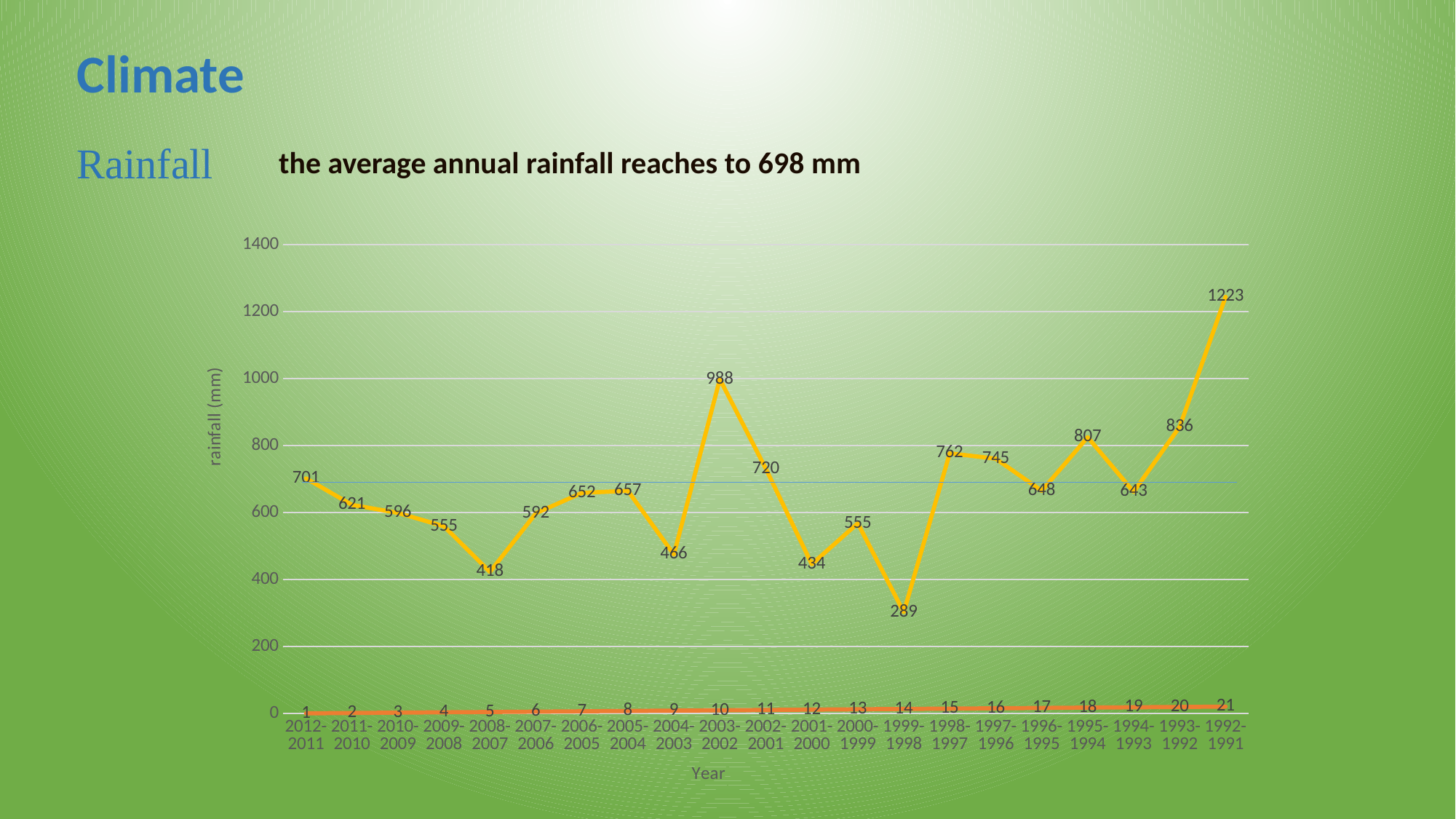
What is the rainfall value for 2003-2002? 988 Which year has the highest rainfall? 1992-1991 Which year has the lowest rainfall? 1999-1998 What is the difference in rainfall between 2003-2002 and 2004-2003? 522 What is the label of the y axis? rainfall (mm) Which has higher rainfall, 1995-1994 or 1996-1995? 1995-1994 What is the rainfall value for 2008-2007? 418 How many year categories are shown on the x axis? 21 What is the rainfall value for 2012-2011? 701 What is the difference in rainfall between 1992-1991 and 1999-1998? 934 Is the rainfall value for 1993-1992 greater or less than 800? greater What kind of chart is shown on the slide? line chart